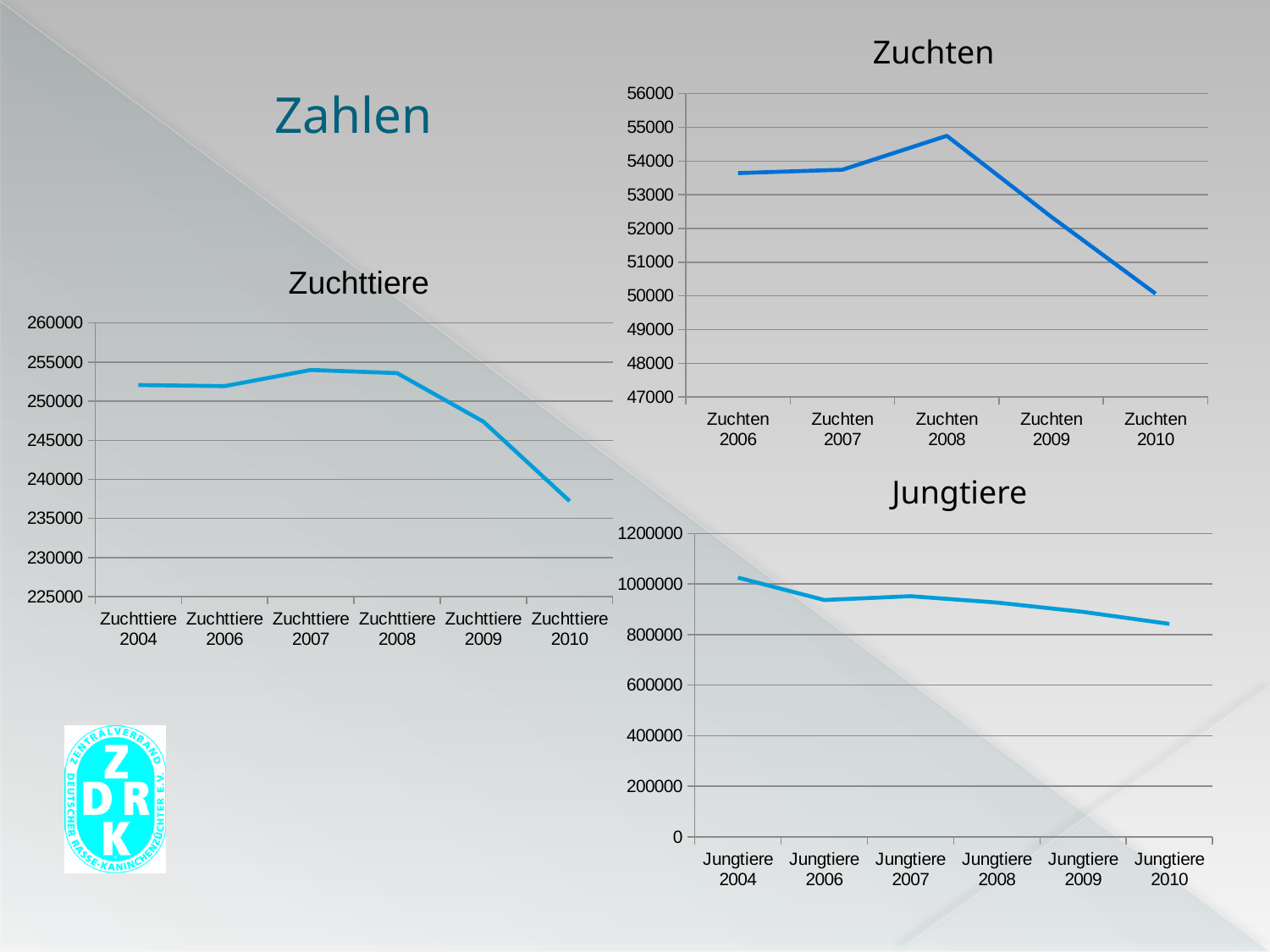
In the Zuchten chart, which year has the highest value? Zuchten 2008 How many data points are plotted in the Jungtiere chart? 6 In the Jungtiere chart, is the value for Jungtiere 2004 greater or less than 1000000? greater In the Zuchttiere chart, which year has the lowest value? Zuchttiere 2010 In the Zuchttiere chart, is the value for Zuchttiere 2010 greater or less than 240000? less What kind of chart is the Zuchttiere chart? line chart In the Jungtiere chart, which is larger, the value for Jungtiere 2006 or Jungtiere 2010? Jungtiere 2006 In the Zuchten chart, do the values rise or fall between Zuchten 2008 and Zuchten 2010? fall In the Zuchten chart, is the value for Zuchten 2008 greater or less than 54000? greater In the Jungtiere chart, which year has the highest value? Jungtiere 2004 How many data points are plotted in the Zuchten chart? 5 In the Zuchten chart, which year has the lowest value? Zuchten 2010